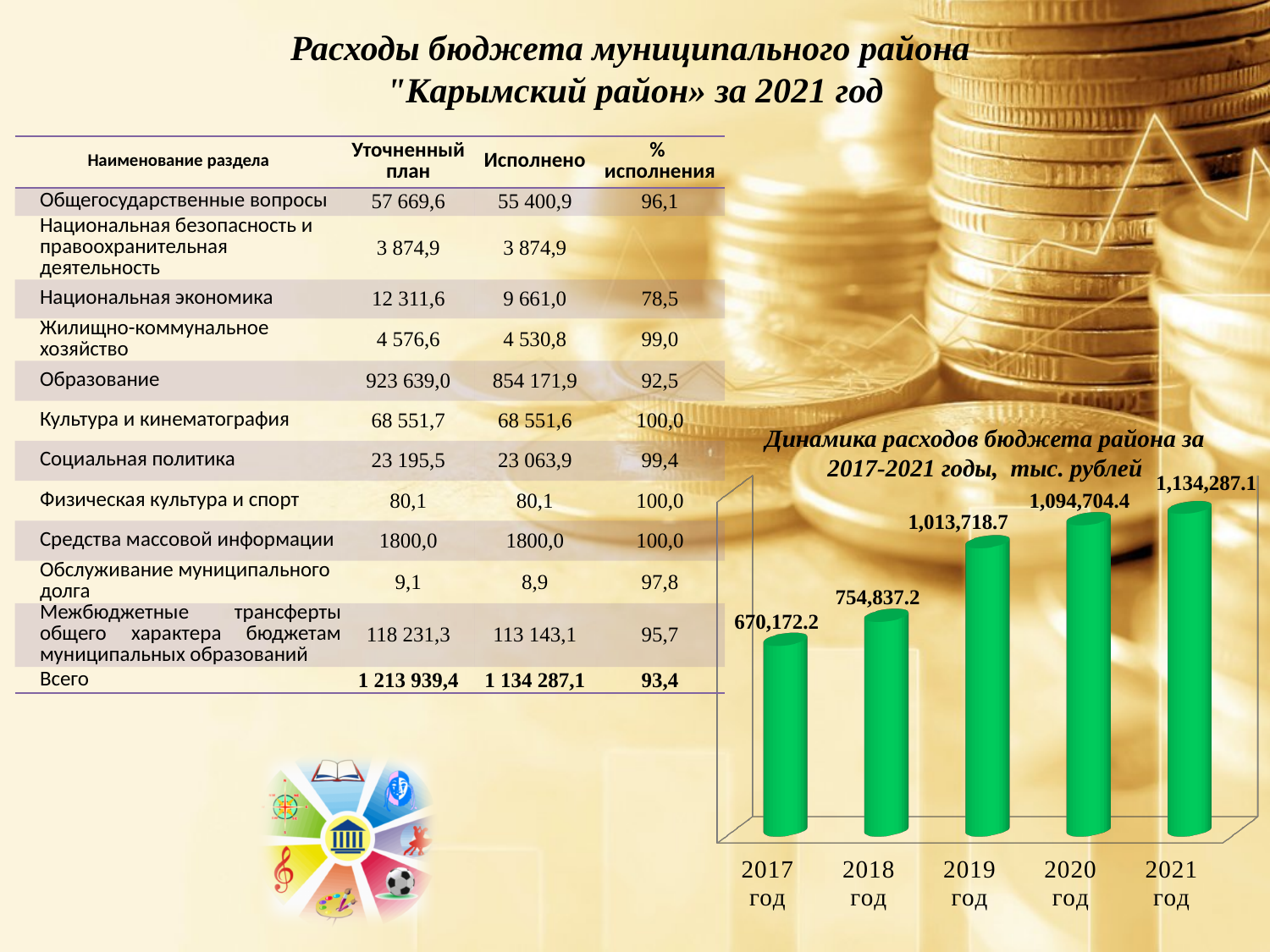
What kind of chart is shown on the slide? bar chart Which year has the lowest value in the chart? 2017 год Do the values rise or fall from 2017 год to 2021 год? rise What is the value for 2019 год in the chart? 1,013,718.7 What is the value for 2017 год in the chart? 670,172.2 What unit is stated in the chart title? тыс. рублей What is the value for 2021 год in the chart? 1,134,287.1 How many years are shown in the chart? 5 Which is larger, the value for 2018 год or the value for 2020 год? 2020 год What is the difference between the values for 2021 год and 2017 год? 464,114.9 What is the difference between the values for 2019 год and 2018 год? 258,881.5 Which year has the highest value in the chart? 2021 год